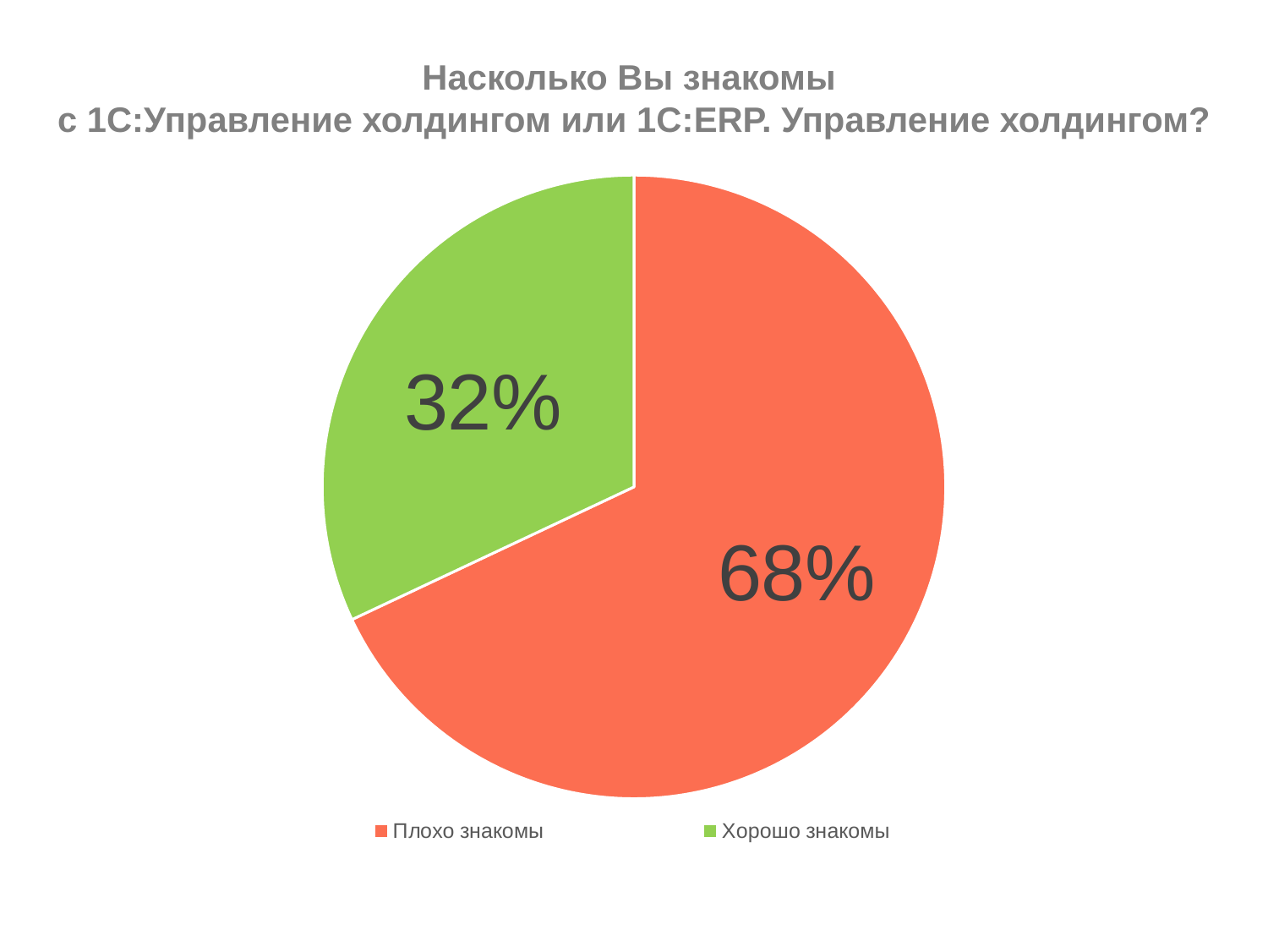
What colour is the "Хорошо знакомы" slice? Green Which category has the smallest slice of the pie? Хорошо знакомы What share of the pie is labelled "Хорошо знакомы"? 32% Which slice is larger: "Плохо знакомы" or "Хорошо знакомы"? Плохо знакомы What colour is the "Плохо знакомы" slice? Orange-red Which category has the largest slice of the pie? Плохо знакомы What kind of chart is shown on the slide? Pie chart What share of the pie is labelled "Плохо знакомы"? 68% How many slices does the pie chart have? 2 What is the difference in percentage points between the "Плохо знакомы" and "Хорошо знакомы" slices? 36% How many entries does the legend list? 2